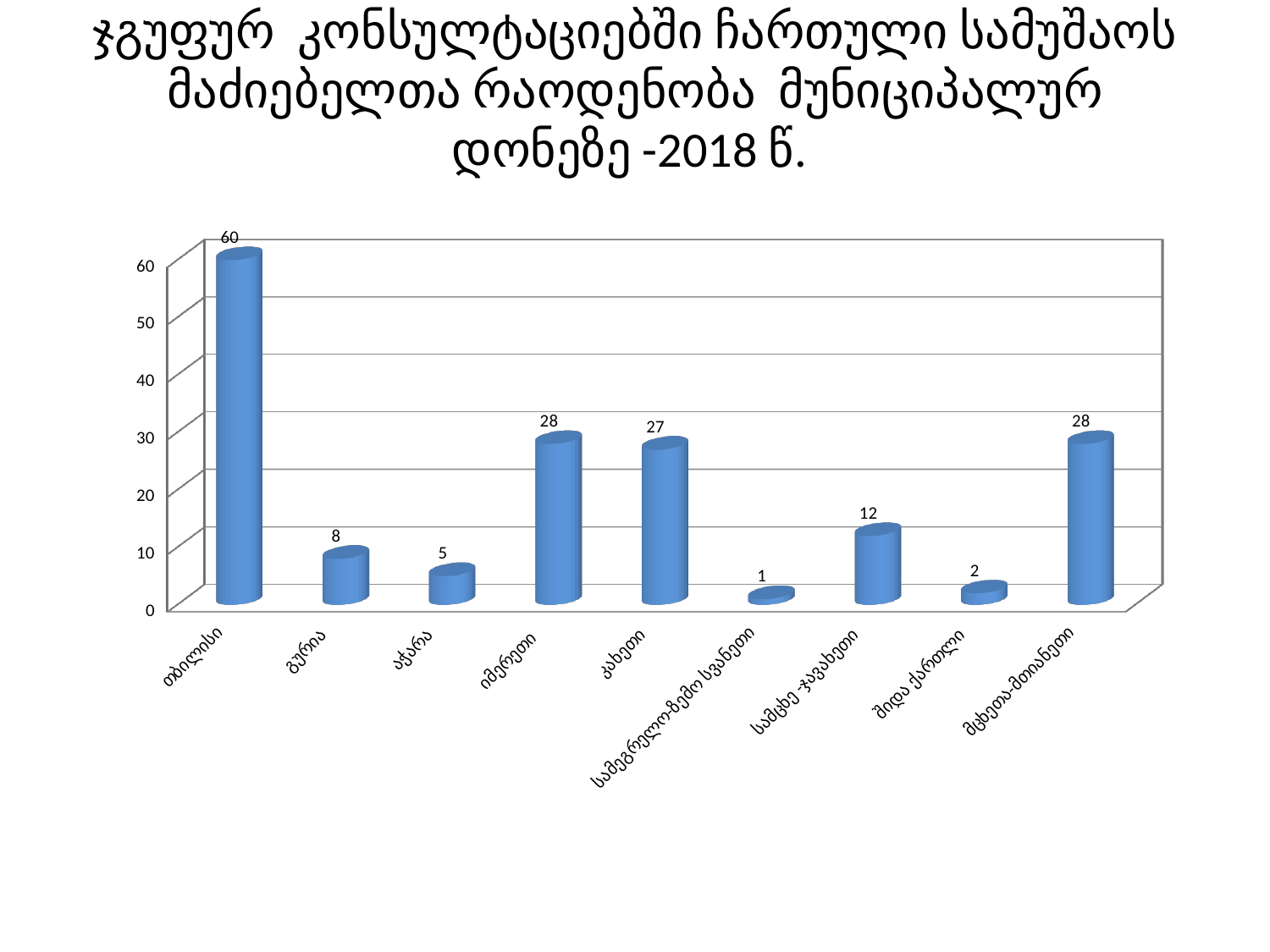
Which category has the highest value? თბილისი How many categories are shown on the x axis? 9 What kind of chart is shown on the slide? bar chart Is the value for მცხეთა-მთიანეთი greater or less than 20? greater Which category has the lowest value? სამეგრელო-ზემო სვანეთი What is the value for შიდა ქართლი? 2 What is the value for თბილისი? 60 Which is larger, the value for სამცხე-ჯავახეთი or the value for გურია? სამცხე-ჯავახეთი What is the difference between the values for თბილისი and იმერეთი? 32 What is the value for კახეთი? 27 What is the value for სამცხე-ჯავახეთი? 12 What is the difference between the values for გურია and აჭარა? 3